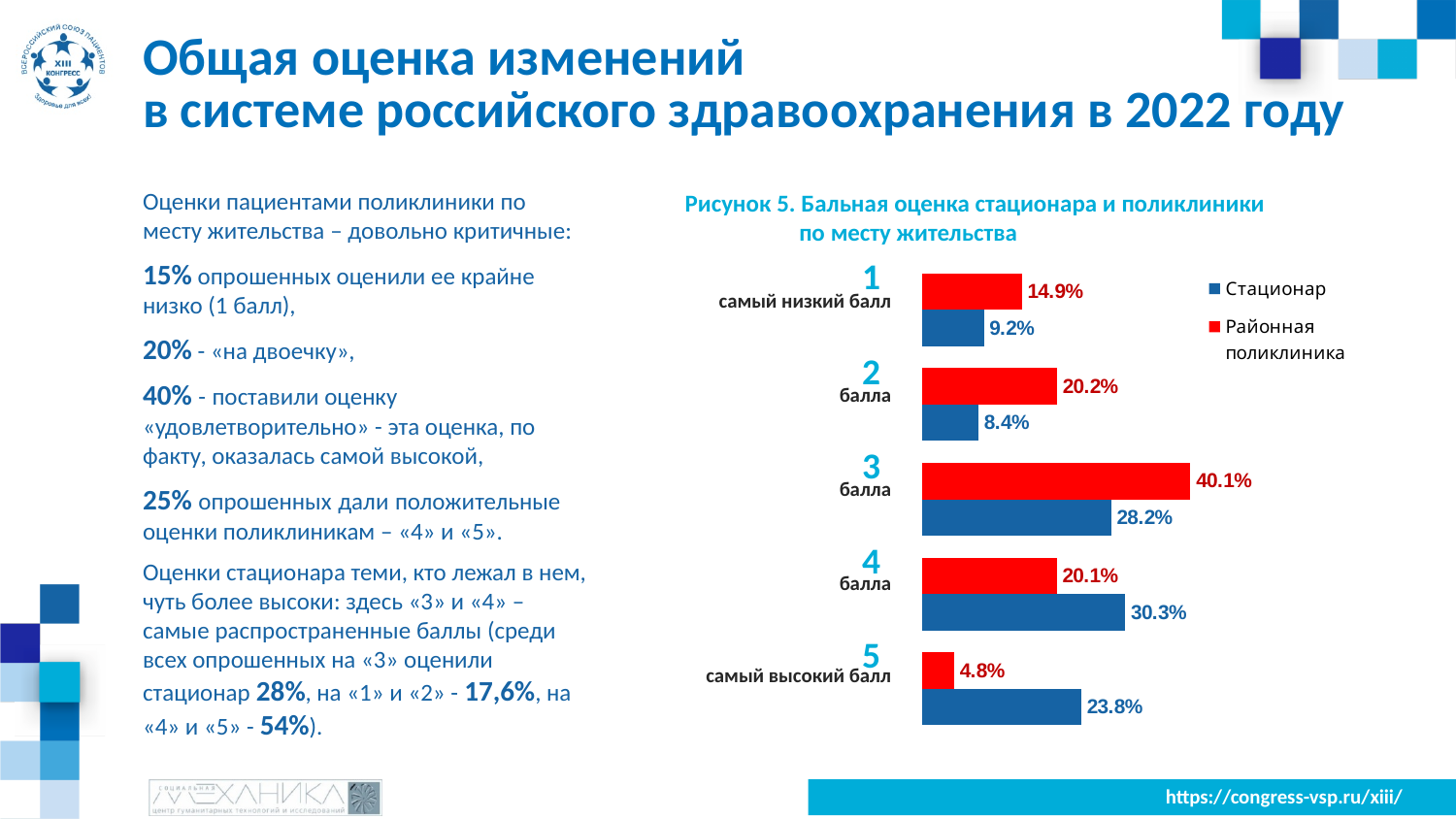
What is the value for Стационар at the lowest score (1, самый низкий балл)? 9.2% What is the value for Районная поликлиника at the highest score (5, самый высокий балл)? 4.8% Which score category has the highest value for Районная поликлиника? 3 балла How many series does the legend list? 2 For the score of 5 (самый высокий балл), which series has the larger value: Стационар or Районная поликлиника? Стационар Which colour represents Районная поликлиника in the chart? Red How many score categories are shown on the chart? 5 Which score category has the lowest value for Стационар? 2 балла What type of chart is shown on the slide? Bar chart What percentage of respondents gave the hospital (Стационар) a score of 4 балла? 30.3% What is the difference between the Районная поликлиника and Стационар values for 3 балла? 11.9% What percentage of respondents gave the district polyclinic (Районная поликлиника) a score of 3 балла? 40.1%